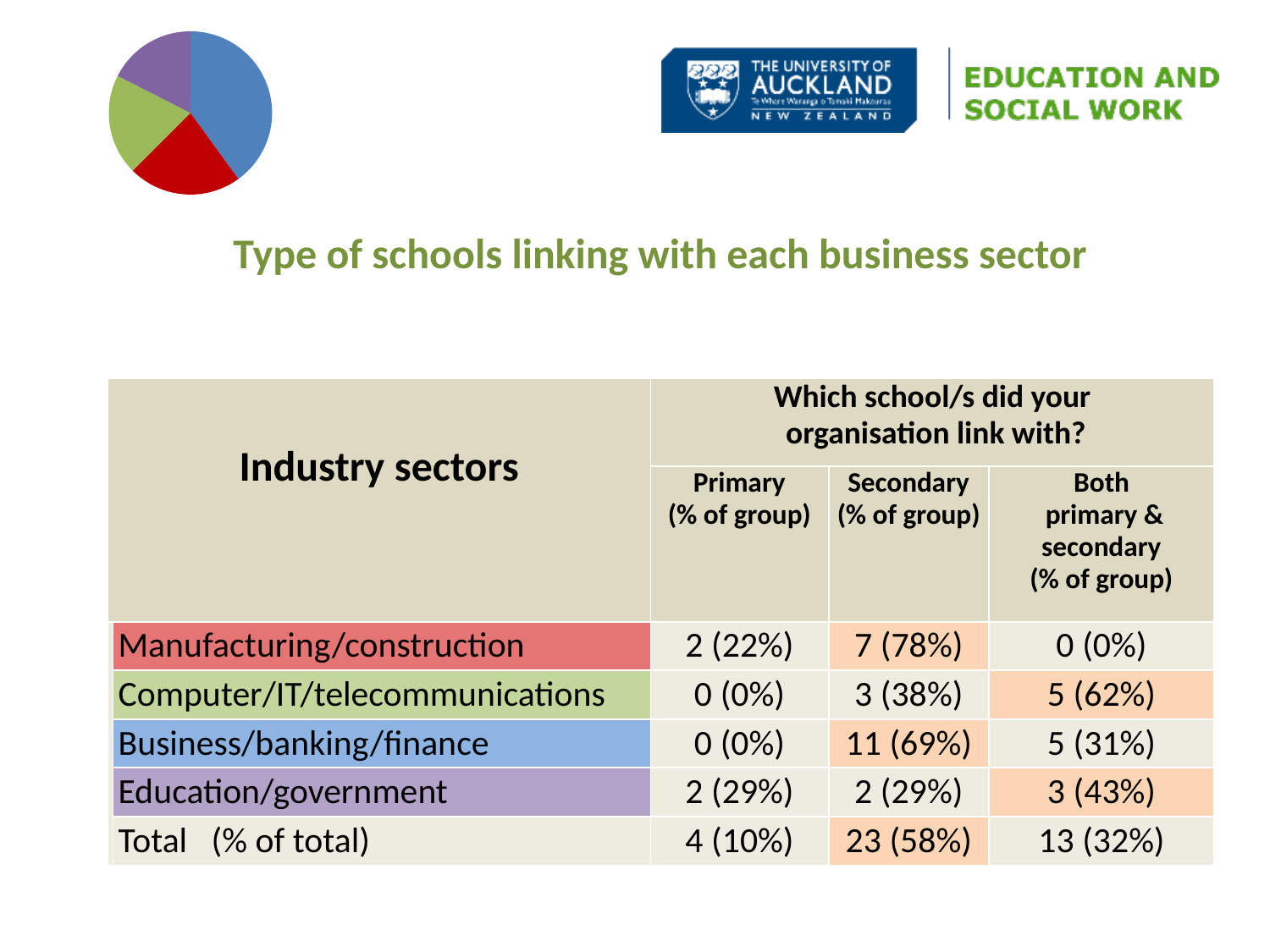
Which of the blue slice and the red slice of the pie chart is larger? blue Which colour slice is the largest in the pie chart? blue Which of the blue slice and the purple slice of the pie chart is larger? blue Using the row colours in the table, which industry sector does the largest (blue) slice of the pie chart represent? Business/banking/finance How many slices does the pie chart have? 4 What kind of chart is shown in the top-left corner of the slide? pie chart Using the row colours in the table, which industry sector does the red slice of the pie chart represent? Manufacturing/construction